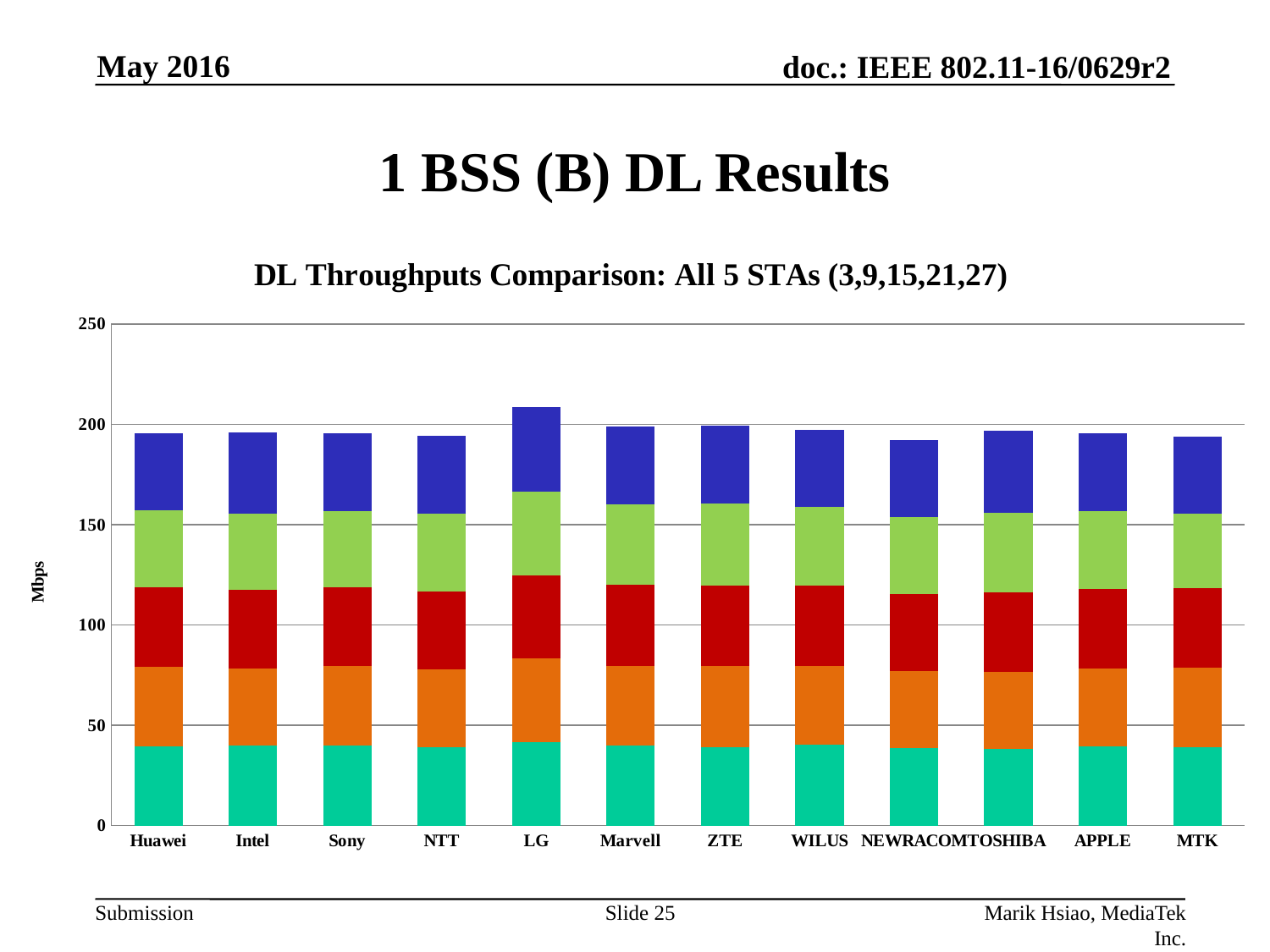
How many companies are shown along the x axis of the chart? 12 Is the total value for Intel greater or less than 150? greater What is the highest value shown on the y axis of the chart? 250 Which has a larger total DL throughput, LG or Huawei? LG What is the title of the chart? DL Throughputs Comparison: All 5 STAs (3,9,15,21,27) Is the total value for LG greater or less than 200? greater Is the total value for Huawei greater or less than 200? less What kind of chart is shown on the slide? stacked bar chart What unit is shown on the y axis of the chart? Mbps Which has a larger total DL throughput, LG or NEWRACOM? LG Which company has the highest total DL throughput in the chart? LG